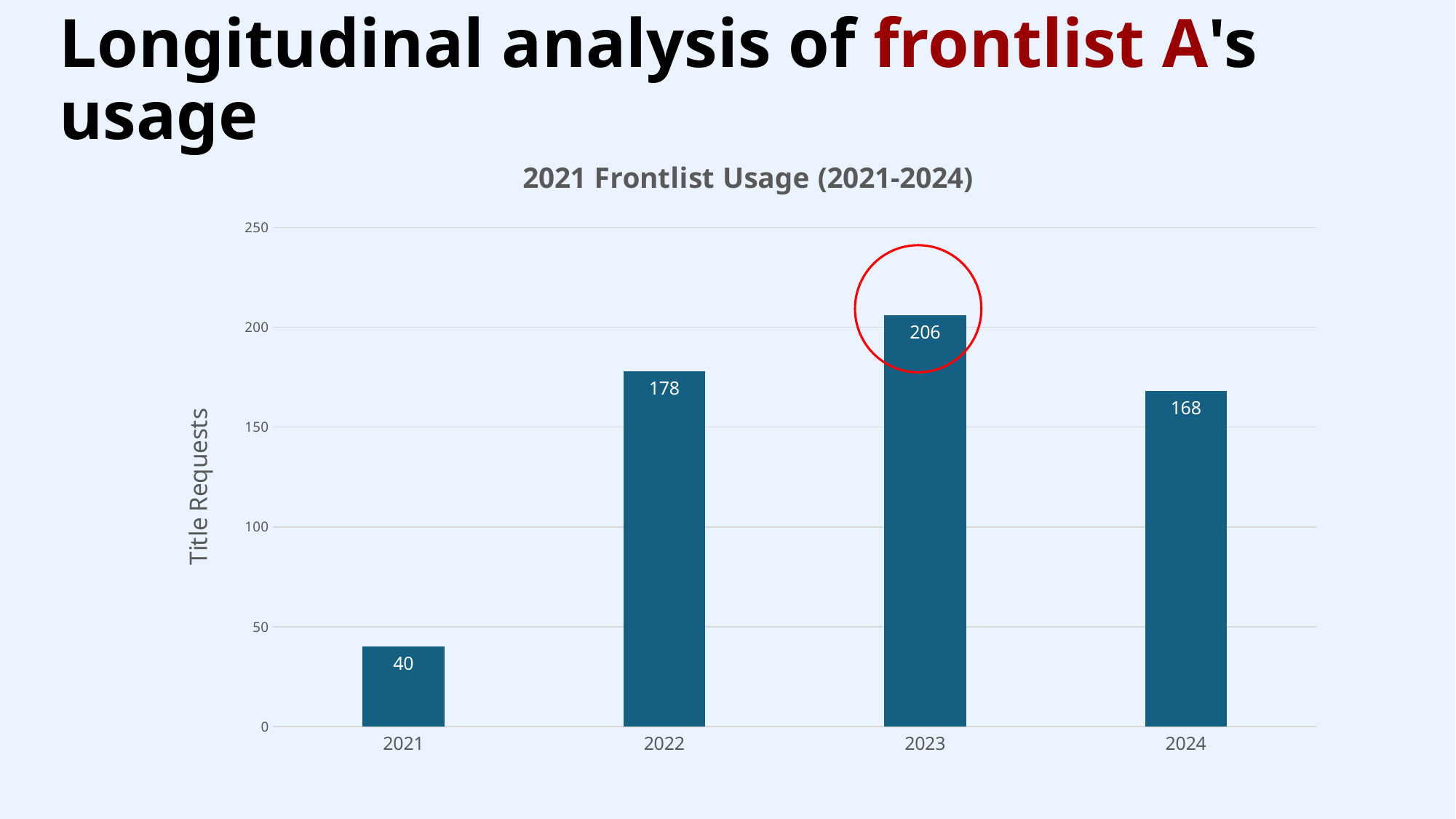
What kind of chart is this? bar chart What is the difference between the values for 2023 and 2024? 38 What is the value for 2023? 206 Which year has the lowest value? 2021 What is the value for 2021? 40 What is the title of the chart? 2021 Frontlist Usage (2021-2024) Which is larger, the value for 2022 or the value for 2024? 2022 Is the value for 2023 greater or less than 200? greater How many years are shown on the x axis? 4 What is the value for 2024? 168 Which year has the highest value? 2023 What is the value for 2022? 178